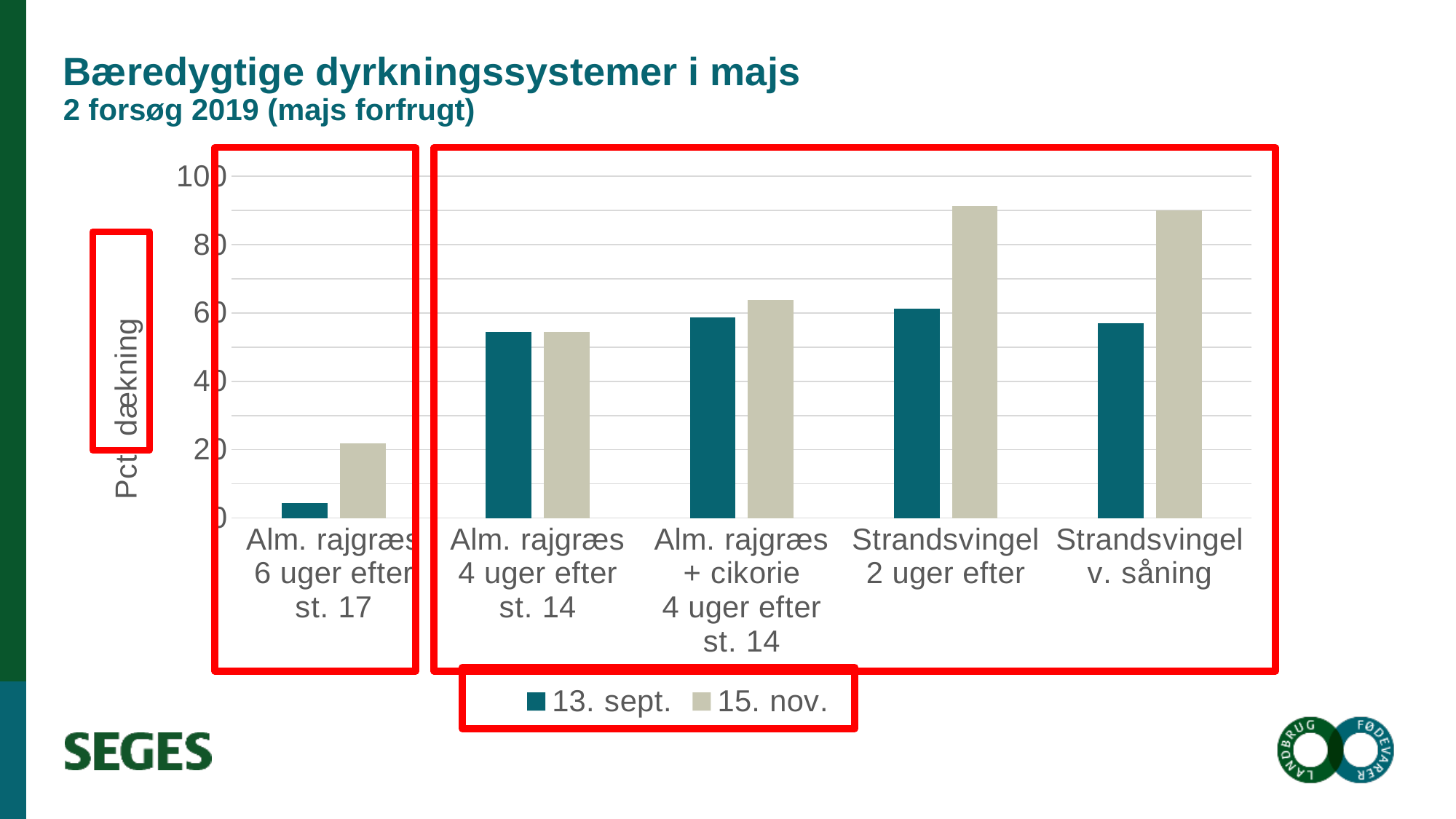
Is the 13. sept. value for Alm. rajgræs 4 uger efter st. 14 greater or less than 60? less What kind of chart is shown on the slide? bar chart For Alm. rajgræs 6 uger efter st. 17, which series has the larger value, 13. sept. or 15. nov.? 15. nov. Which category has the lowest value for the 15. nov. series? Alm. rajgræs 6 uger efter st. 17 Is the 15. nov. value for Strandsvingel v. såning greater or less than 80? greater For Strandsvingel 2 uger efter, which series has the larger value, 13. sept. or 15. nov.? 15. nov. Which category has the lowest value for the 13. sept. series? Alm. rajgræs 6 uger efter st. 17 How many categories are shown on the x axis of the chart? 5 Is the 13. sept. value for Alm. rajgræs 6 uger efter st. 17 greater or less than 20? less How many series does the chart's legend list? 2 What is the label on the chart's y axis? Pct. dækning What are the two series named in the chart's legend? 13. sept. and 15. nov.